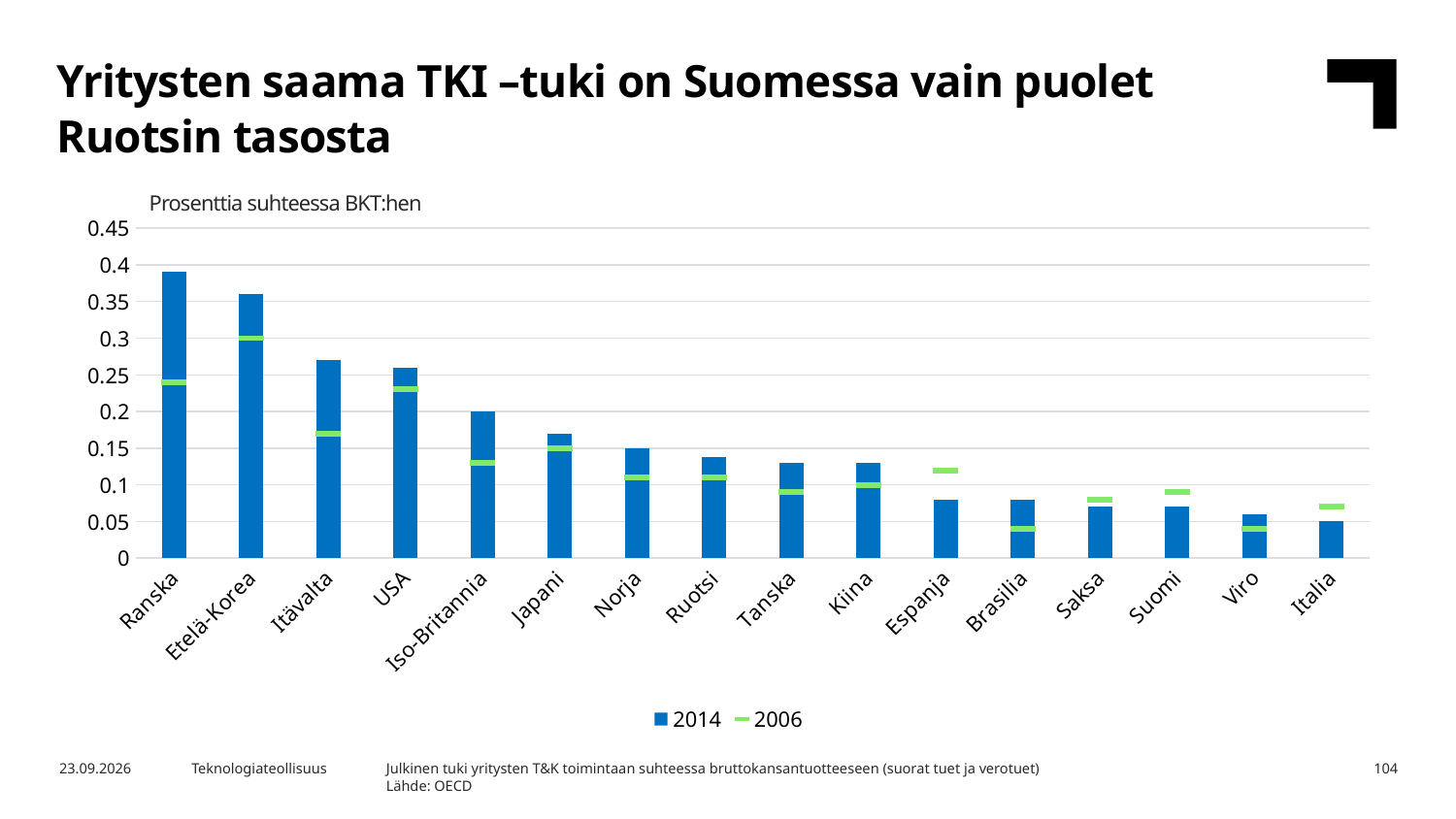
How many countries are shown on the x axis of the chart? 16 Is the 2014 value for Ranska greater or less than 0.35? greater What are the two series named in the chart legend? 2014 and 2006 Is the 2014 value for Suomi greater or less than 0.1? less What is the title shown above the chart's y axis? Prosenttia suhteessa BKT:hen Is the 2014 value for Etelä-Korea greater or less than 0.3? greater How many series does the chart legend list? 2 Which has the larger 2014 value, Ranska or Suomi? Ranska Do the 2014 values rise or fall moving from left to right along the x axis? fall Which country has the highest 2014 value in the chart? Ranska What kind of chart is shown on the slide? bar chart